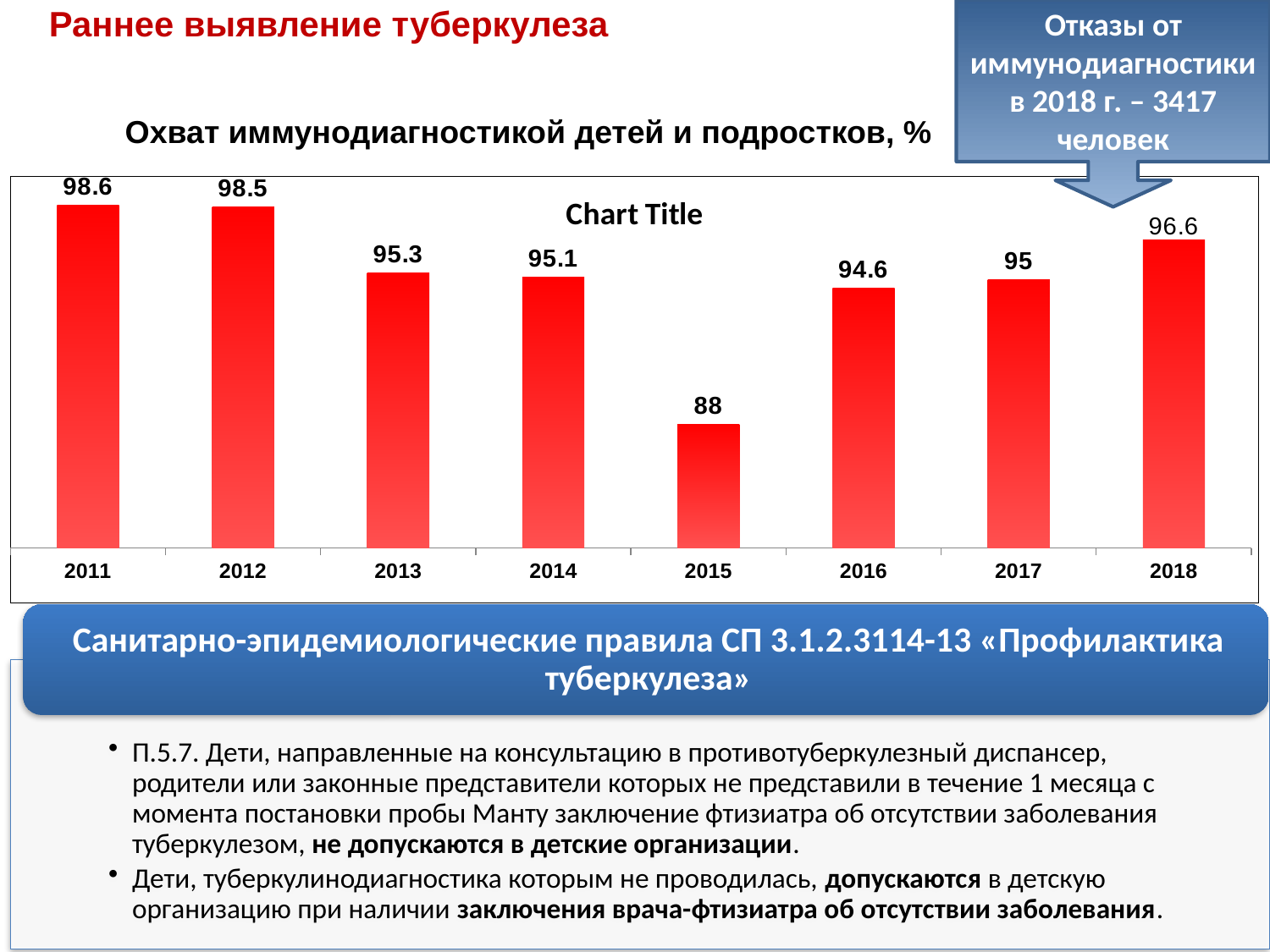
Which year has the lowest value? 2015 How many years are shown on the x axis? 8 What is the difference between the values for 2011 and 2015? 10.6 What is the value for 2015? 88 What is the value for 2018? 96.6 What is the difference between the values for 2018 and 2017? 1.6 What is the value for 2016? 94.6 Which year has the highest value? 2011 What kind of chart is shown? bar chart Do the values rise or fall from 2015 to 2018? rise Which is larger, the value for 2013 or the value for 2016? 2013 What is the value for 2011? 98.6